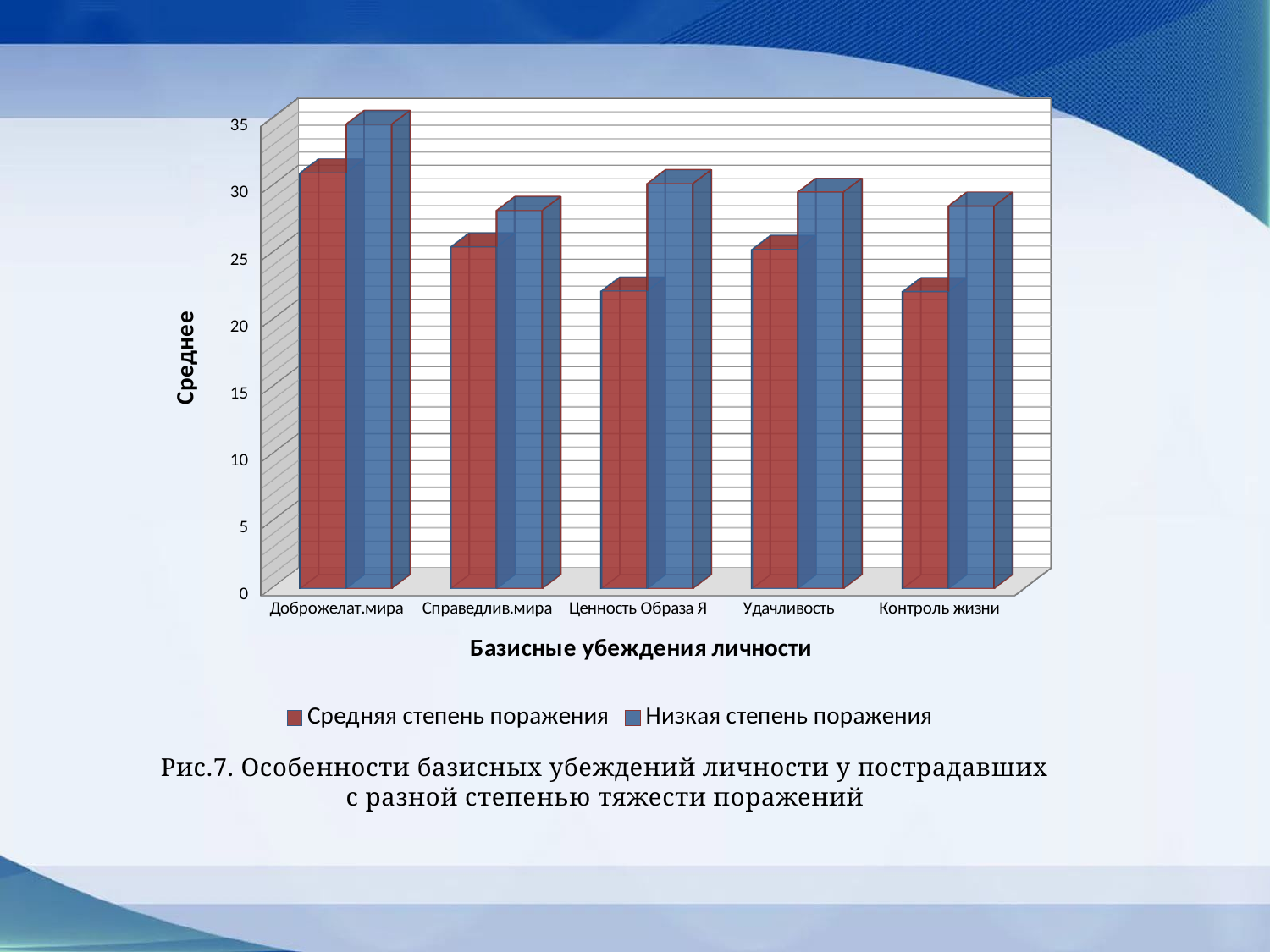
How many series does the chart's legend list? 2 Is the value for 'Средняя степень поражения' in the category 'Ценность Образа Я' greater or less than 25? less What is the title of the vertical axis of the chart? Среднее For the category 'Ценность Образа Я', which series has the larger value? Низкая степень поражения Is the value for 'Низкая степень поражения' in the category 'Справедлив.мира' greater or less than 25? greater For the category 'Контроль жизни', which series has the larger value? Низкая степень поражения Which category has the highest value for the series 'Средняя степень поражения'? Доброжелат.мира Which category has the highest value for the series 'Низкая степень поражения'? Доброжелат.мира Is the value for 'Средняя степень поражения' in the category 'Доброжелат.мира' greater or less than 25? greater How many categories are shown on the x axis of the chart? 5 What kind of chart is shown on the slide? bar chart